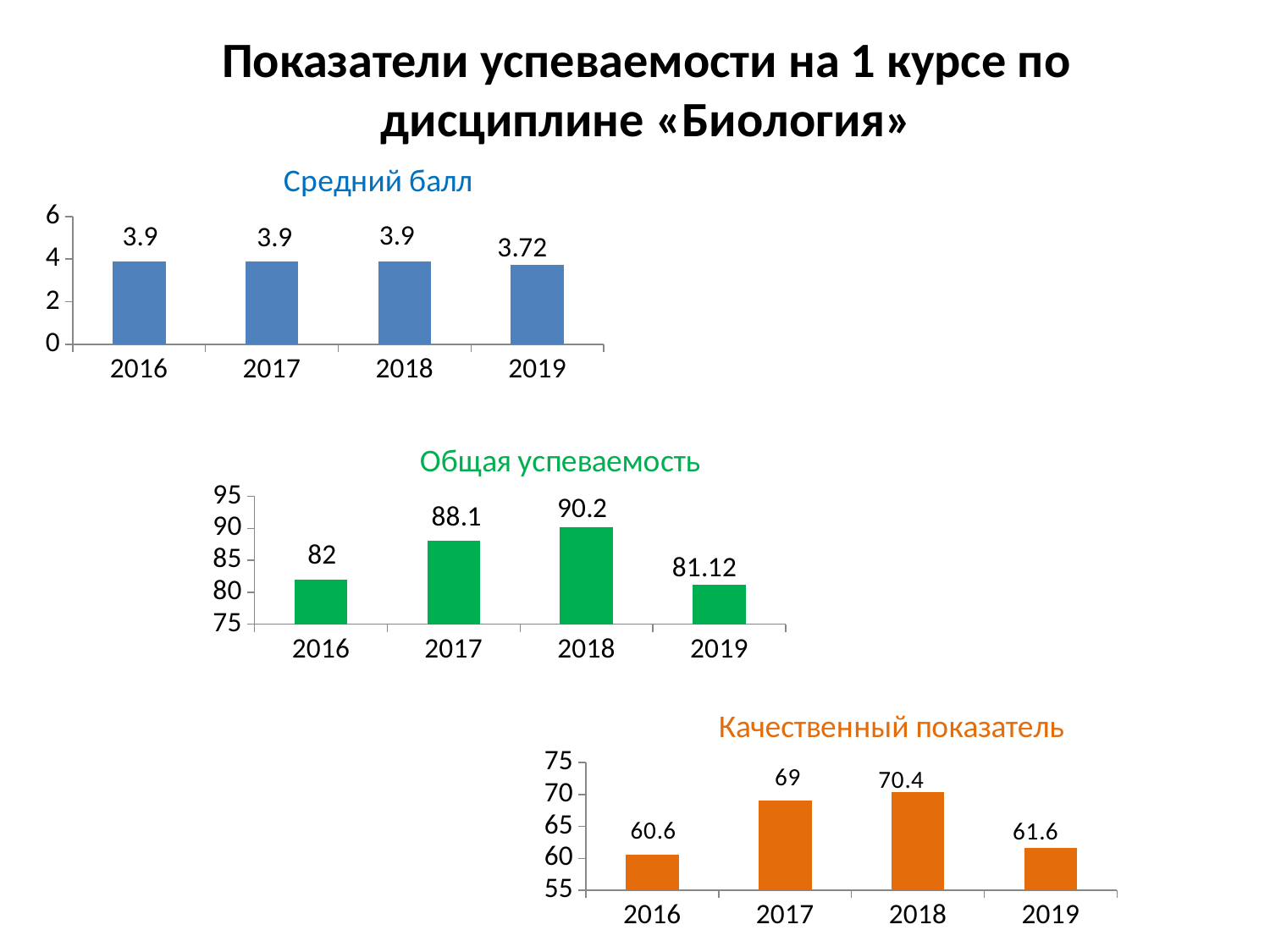
How many years are shown on the x axis of the "Средний балл" chart? 4 In the "Качественный показатель" chart, what is the difference between the values for 2018 and 2017? 1.4 In the "Общая успеваемость" chart, what is the value for 2017? 88.1 In the "Средний балл" chart, what is the value for 2019? 3.72 In the "Средний балл" chart, which year has the lowest value? 2019 What type of chart is the "Общая успеваемость" chart? bar chart In the "Общая успеваемость" chart, is the value for 2016 greater or less than 85? less In the "Общая успеваемость" chart, which year has the highest value? 2018 In the "Качественный показатель" chart, which year has the highest value? 2018 In the "Качественный показатель" chart, what is the value for 2016? 60.6 In the "Общая успеваемость" chart, what is the difference between the values for 2018 and 2019? 9.08 In the "Качественный показатель" chart, which is larger, the value for 2017 or the value for 2019? 2017